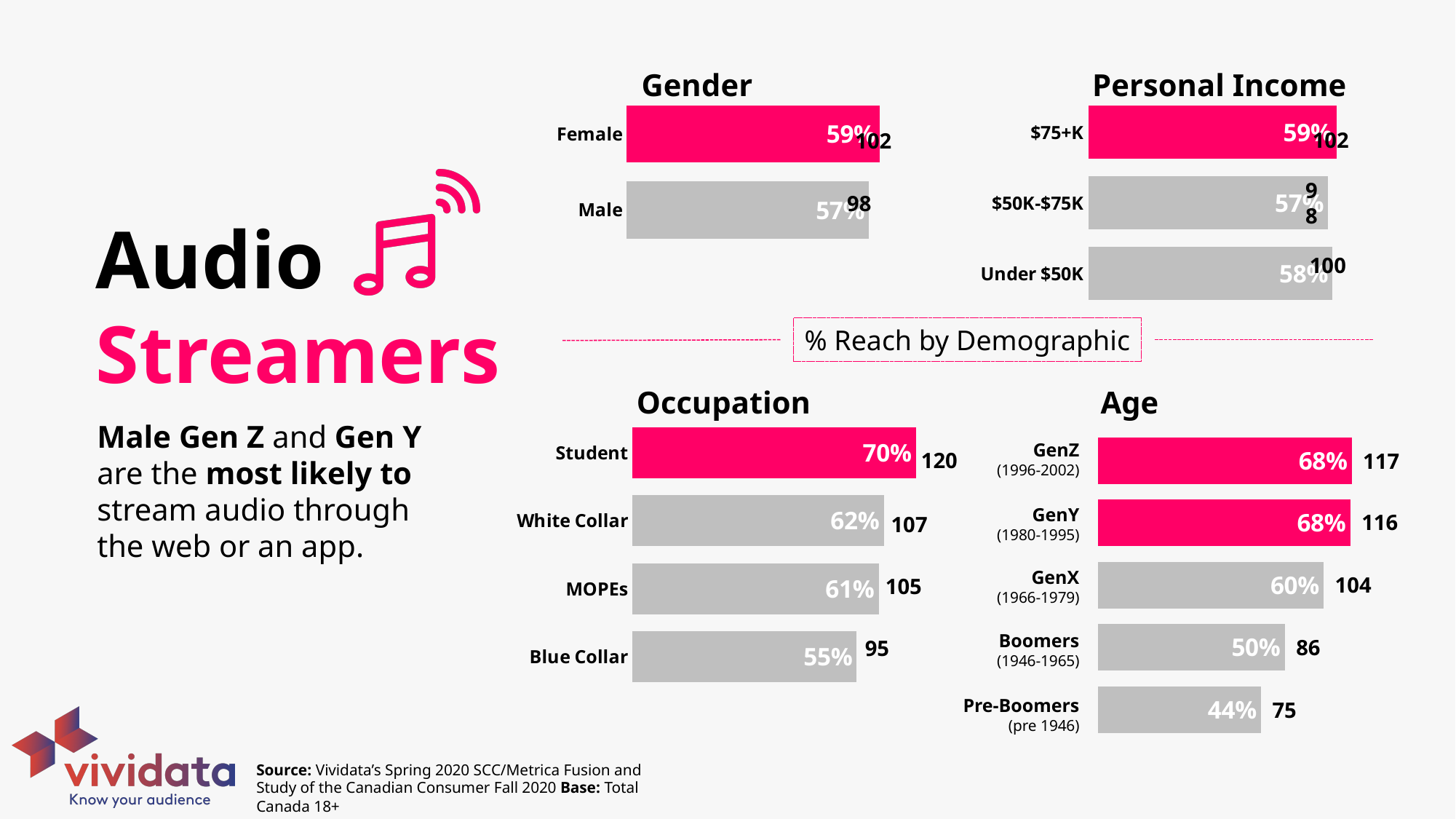
In the Age chart, which category has the lowest % reach? Pre-Boomers In the Gender chart, what is the % reach for Female? 59% In the Occupation chart, what is the % reach for Student? 70% In the Age chart, what is the % reach for Boomers (1946-1965)? 50% How many categories are shown in the Age chart? 5 In the Occupation chart, what is the difference in % reach between Student and Blue Collar? 15% In the Occupation chart, which category has the highest % reach? Student In the Age chart, what is the difference in % reach between GenX and Pre-Boomers? 16% What type of chart is the Personal Income chart? Bar chart In the Gender chart, which has the larger % reach, Female or Male? Female How many categories are shown in the Occupation chart? 4 In the Personal Income chart, what is the % reach for Under $50K? 58%